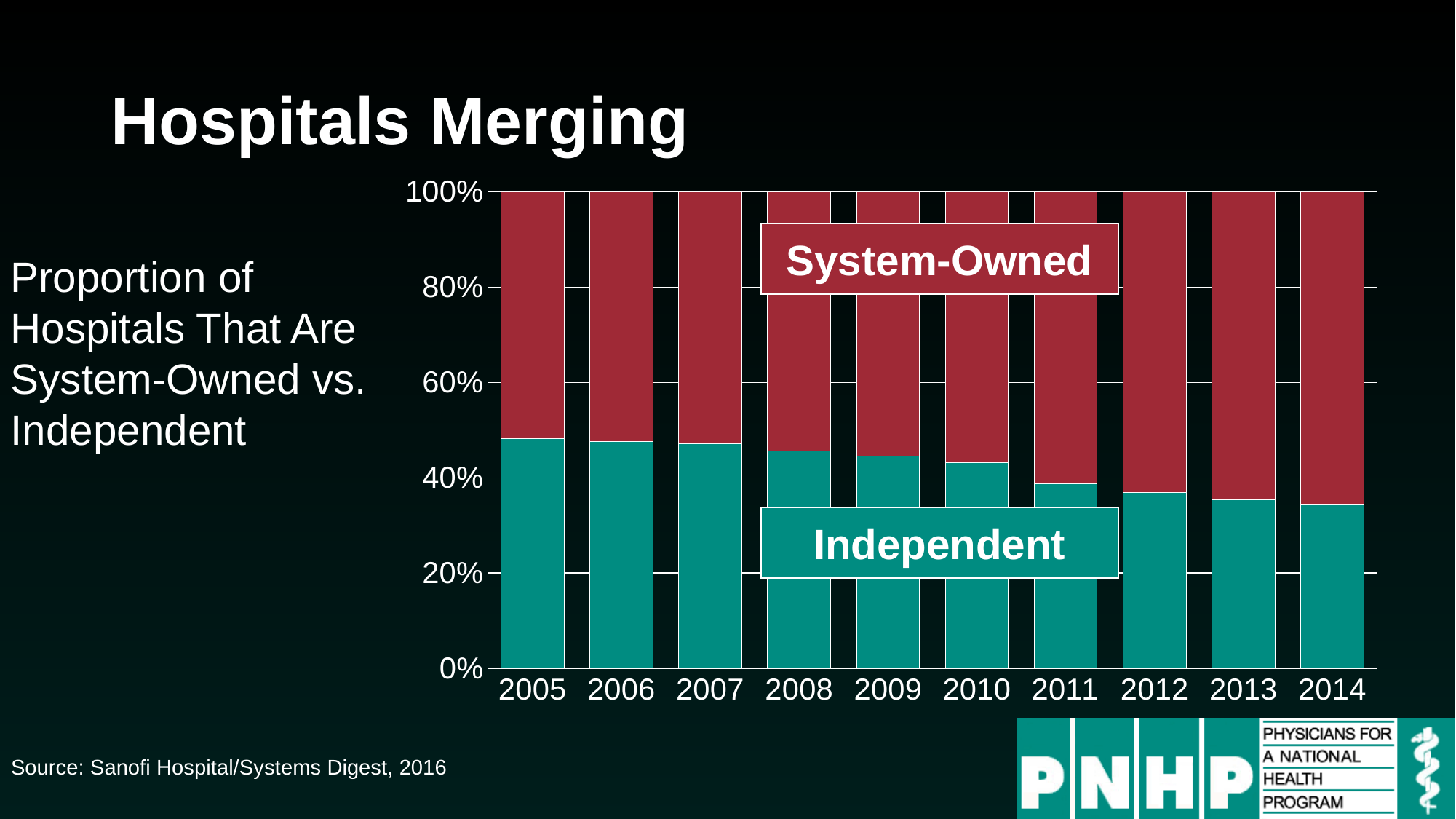
What are the two series shown in the chart? System-Owned and Independent Is the Independent share in 2014 greater or less than 40%? less Is the Independent share in 2005 greater or less than 40%? greater Does the System-Owned share rise or fall from 2005 to 2014? Rise How many years are shown along the x axis of the chart? 10 In which year is the Independent share the highest? 2005 How many series does the chart show? 2 What kind of chart is shown on the slide? Stacked bar chart Is the System-Owned share in 2014 greater or less than 60%? greater Does the Independent share rise or fall from 2005 to 2014? Fall What is the title of the slide containing the chart? Hospitals Merging Which year has the larger Independent share, 2005 or 2014? 2005